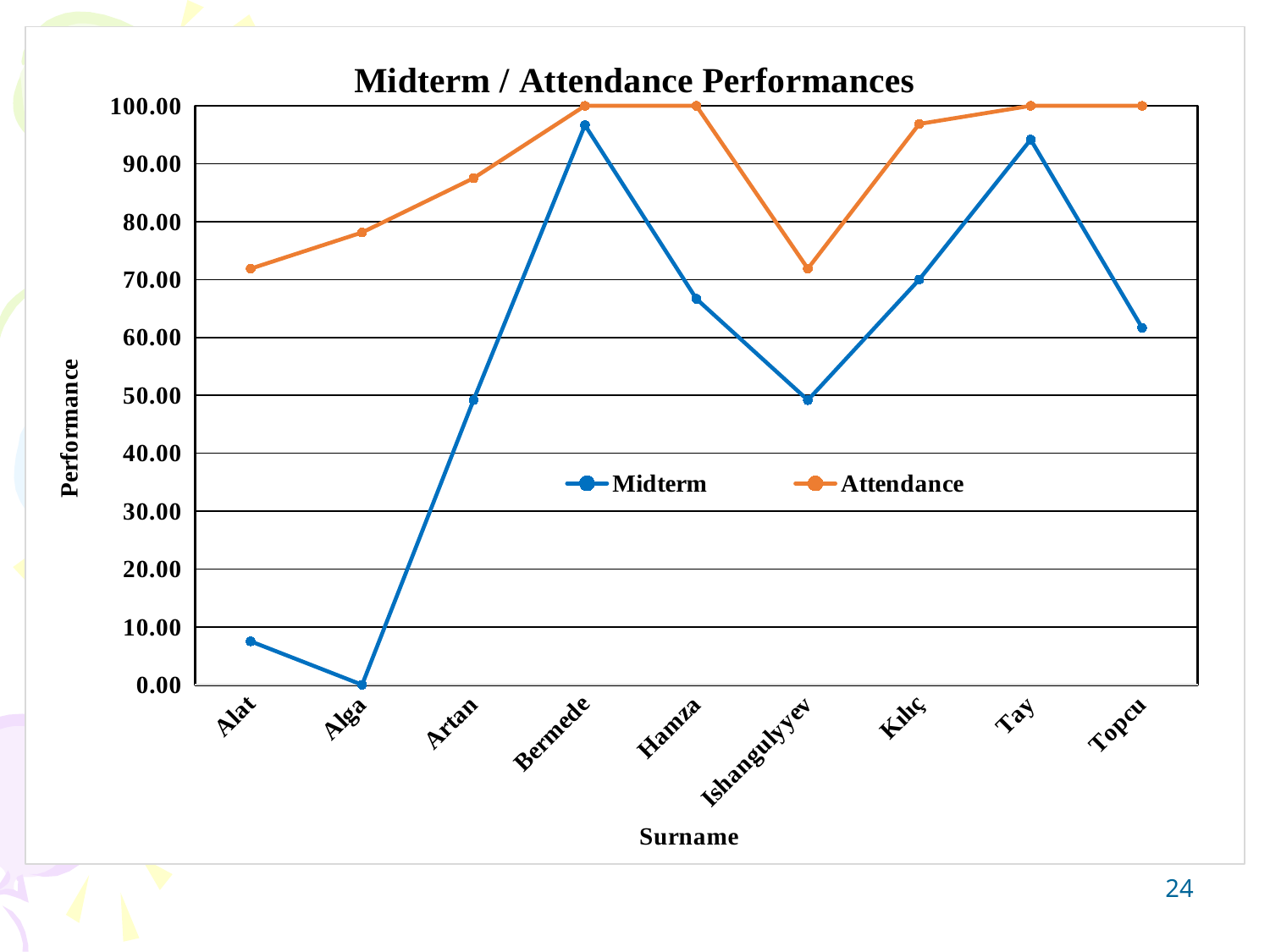
What is the Attendance value for Bermede? 100.00 Is the Midterm value for Alat greater or less than 10.00? less What is the title of the chart? Midterm / Attendance Performances What kind of chart is shown on the slide? line chart Is the Attendance value for Artan greater or less than 80.00? greater How many surnames are plotted along the x axis? 9 How many series does the legend list? 2 Which surname has the highest Midterm value? Bermede Which surname has the lowest Midterm value? Alga Is the Attendance value for Ishangulyyev greater or less than 80.00? less Do the Midterm values rise or fall from Alga to Bermede? rise Which is larger, the Midterm value for Tay or the Midterm value for Hamza? Tay